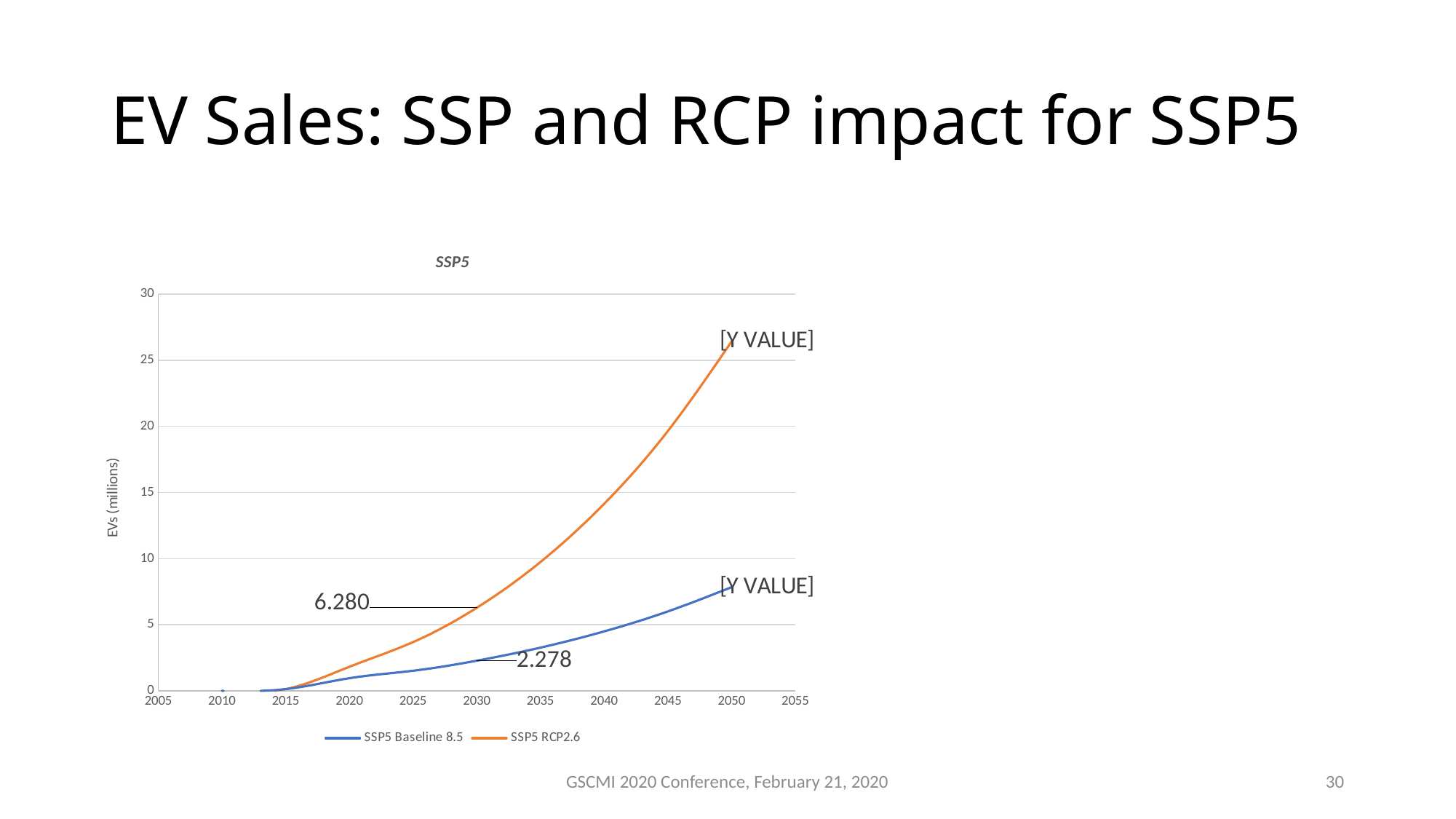
Is the value for SSP5 Baseline 8.5 in 2045 greater or less than 5? greater What value is printed as a data label on the SSP5 Baseline 8.5 line? 2.278 Do the values of the SSP5 RCP2.6 series rise or fall from 2015 to 2050? rise Is the value for SSP5 RCP2.6 in 2050 greater or less than 25? greater What are the two series named in the legend? SSP5 Baseline 8.5 and SSP5 RCP2.6 What value is printed as a data label on the SSP5 RCP2.6 line? 6.280 Is the value for SSP5 Baseline 8.5 in 2050 greater or less than 10? less How many series does the legend list? 2 In 2040, which series has the higher value, SSP5 Baseline 8.5 or SSP5 RCP2.6? SSP5 RCP2.6 What kind of chart is shown on the slide? line chart What is the label on the vertical axis? EVs (millions) What is the difference between the two printed data labels, 6.280 and 2.278? 4.002